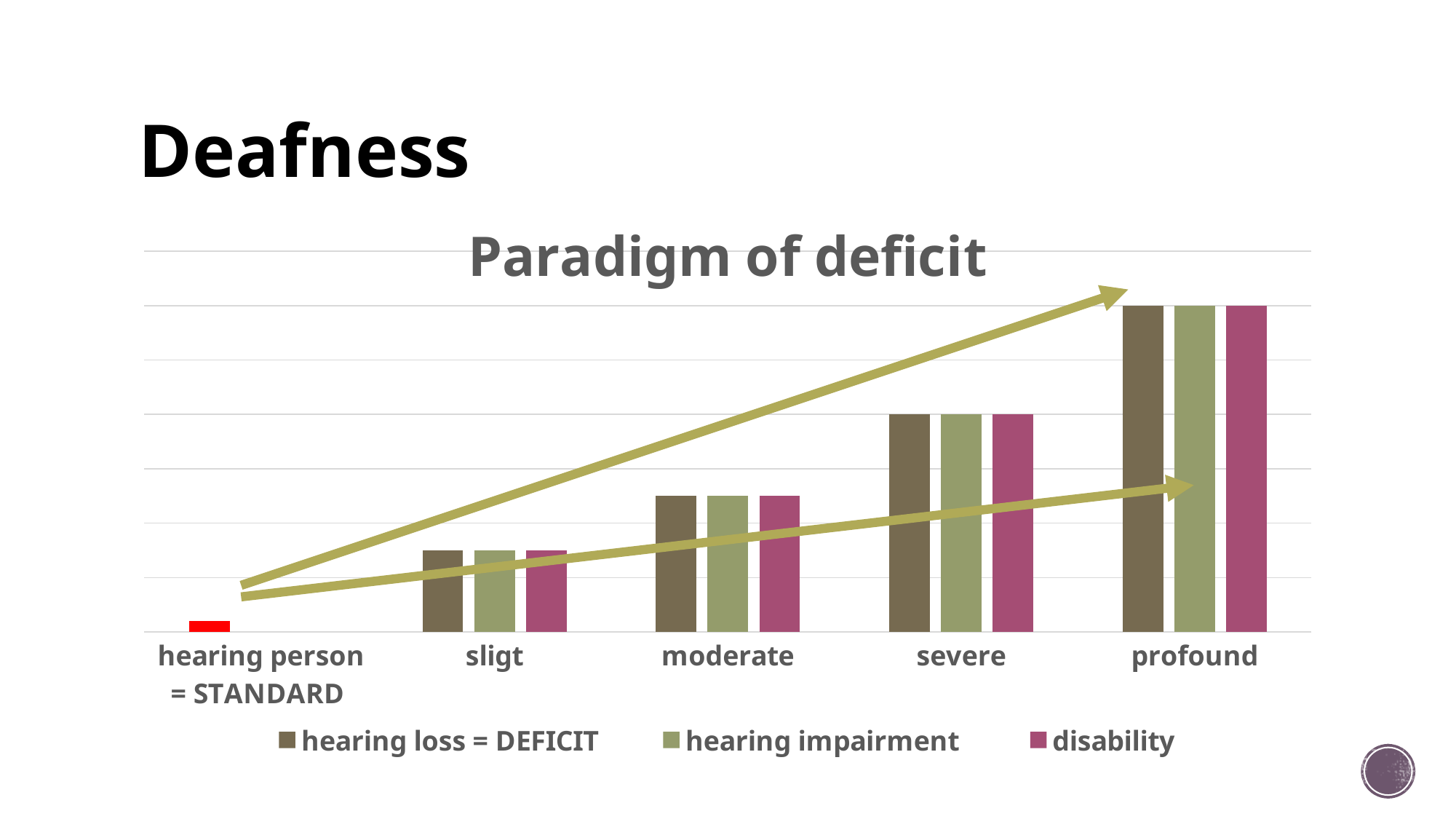
How many series does the legend list? 3 Do the bar values rise or fall from left to right along the x axis? rise Which is larger, the hearing loss = DEFICIT value for severe or for moderate? severe Which category has the highest bars? profound What is the title of the chart? Paradigm of deficit Which is larger, the disability value for sligt or for profound? profound How many categories are shown on the x axis? 5 Which series is listed first in the legend? hearing loss = DEFICIT Which category comes immediately after moderate on the x axis? severe Which category has the lowest bar? hearing person = STANDARD What kind of chart is shown on the slide? bar chart